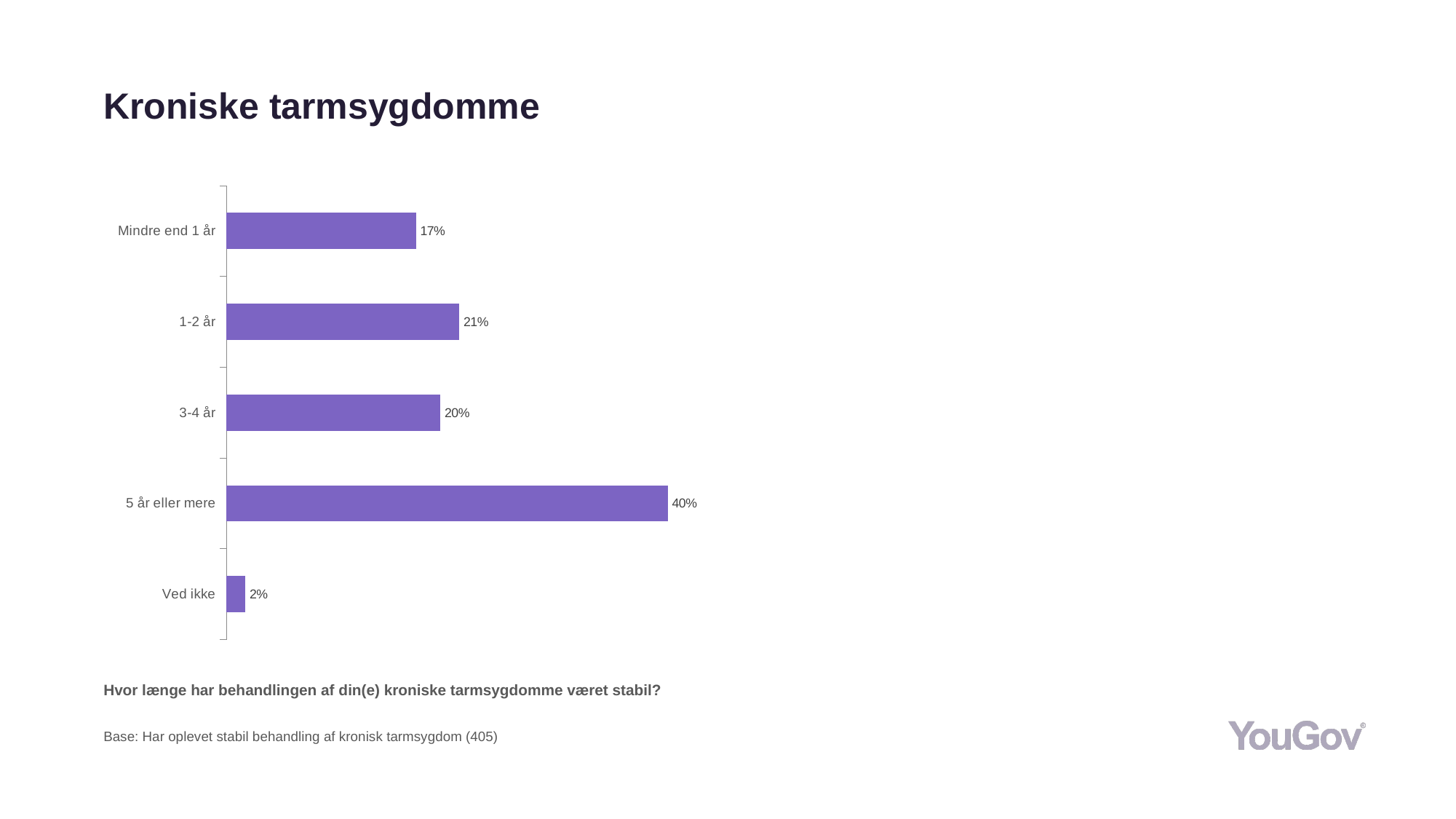
How many categories are shown in the chart? 5 Which category has the lowest value? Ved ikke What is the value for "5 år eller mere"? 40% What is the title of the slide? Kroniske tarmsygdomme Which is larger, the value for "1-2 år" or the value for "Mindre end 1 år"? 1-2 år What kind of chart is shown on the slide? Bar chart What is the value for "1-2 år"? 21% What is the difference between the values for "5 år eller mere" and "3-4 år"? 20% What is the difference between the values for "1-2 år" and "Mindre end 1 år"? 4% Which category has the highest value? 5 år eller mere What is the value for "Mindre end 1 år"? 17% What is the value for "Ved ikke"? 2%